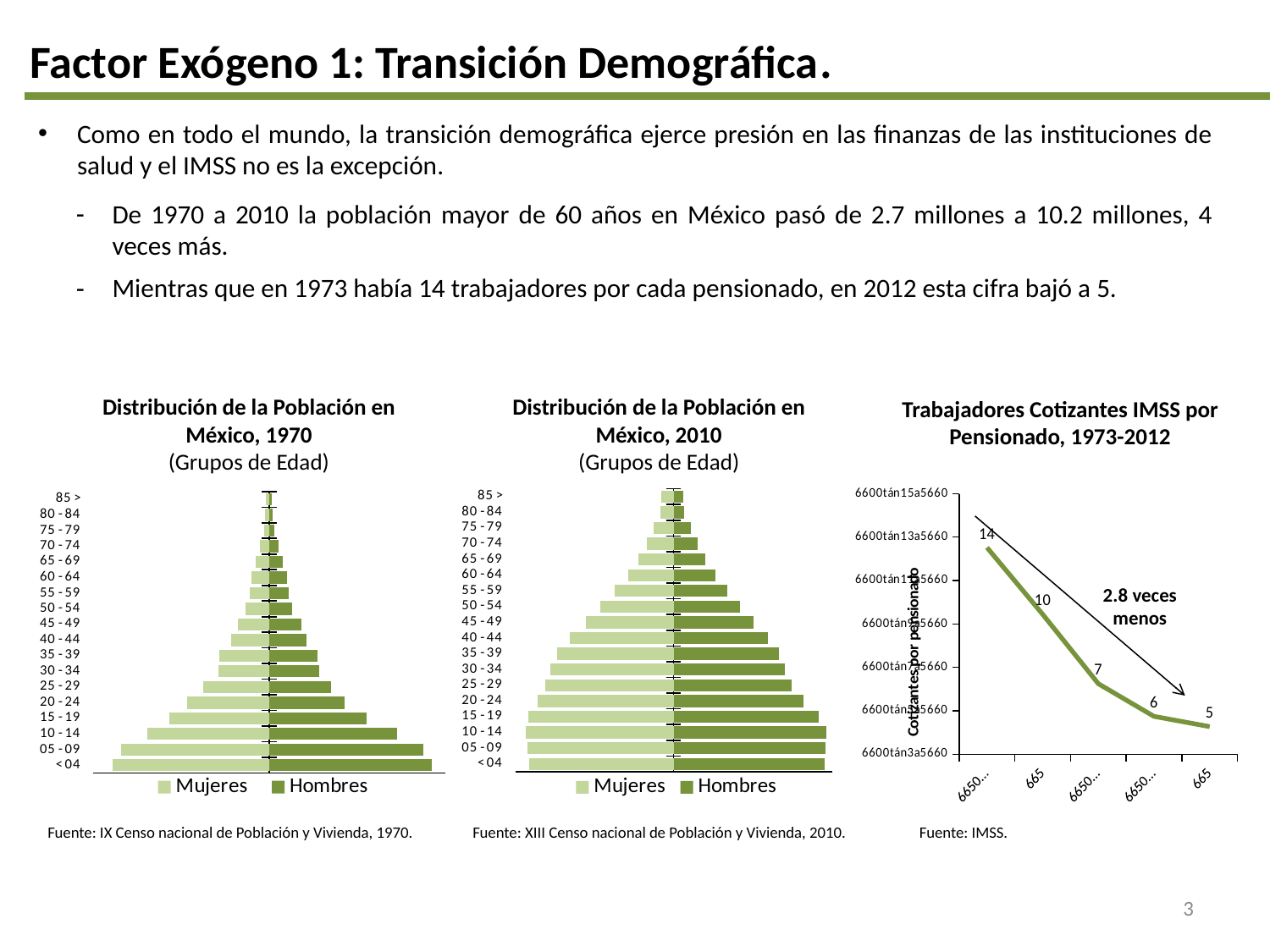
How many series does the legend of the 'Distribución de la Población en México, 2010' chart list? 2 In the 'Trabajadores Cotizantes IMSS por Pensionado, 1973-2012' chart, what is the difference between the labelled values 10 and 7? 3 In the 'Trabajadores Cotizantes IMSS por Pensionado, 1973-2012' chart, what is the difference between the first labelled value and the last labelled value? 9 What kind of chart is the 'Trabajadores Cotizantes IMSS por Pensionado, 1973-2012' chart? line chart What are the two legend entries in the 'Distribución de la Población en México, 1970' chart? Mujeres and Hombres How many age groups are shown on the vertical axis of the 'Distribución de la Población en México, 2010' chart? 18 In the 'Trabajadores Cotizantes IMSS por Pensionado, 1973-2012' chart, what text annotation appears next to the arrow? 2.8 veces menos What kind of chart is 'Distribución de la Población en México, 1970'? bar chart In the 'Trabajadores Cotizantes IMSS por Pensionado, 1973-2012' chart, do the values rise or fall from left to right? fall In the 'Trabajadores Cotizantes IMSS por Pensionado, 1973-2012' chart, how many data points are labelled on the line? 5 In the 'Trabajadores Cotizantes IMSS por Pensionado, 1973-2012' chart, what is the highest labelled value? 14 In the 'Trabajadores Cotizantes IMSS por Pensionado, 1973-2012' chart, what is the lowest labelled value? 5